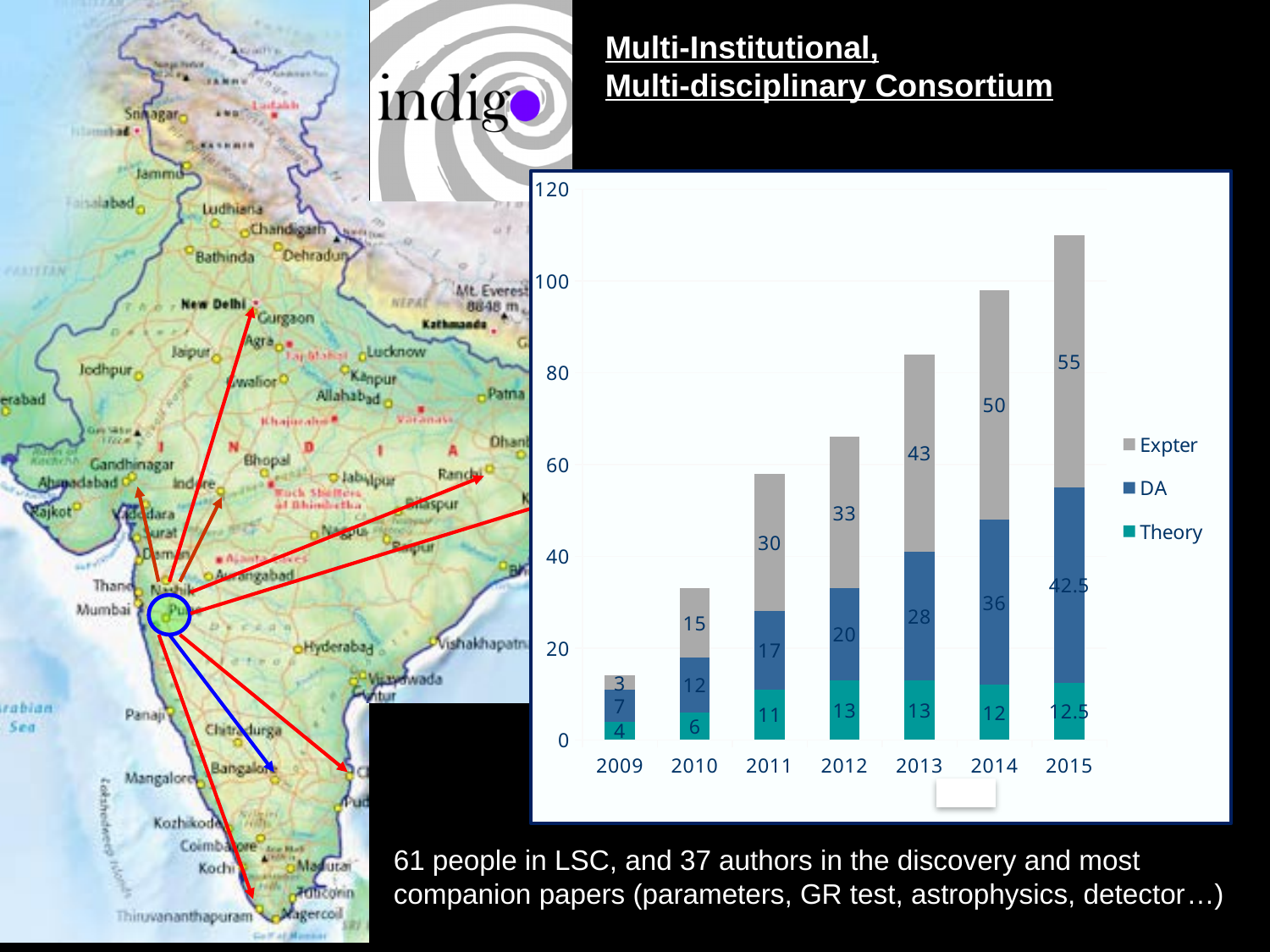
What is the difference between the DA values for 2014 and 2013? 8 Which is larger, the Expter value for 2012 or the Expter value for 2011? 2012 What is the DA value for 2015? 42.5 What is the Theory value for 2011? 11 What type of chart is shown on the slide? stacked bar chart Which year has the highest Expter value? 2015 How many years are shown on the x axis of the chart? 7 What is the total of the stacked bar for 2010? 33 Does the total stacked bar for 2015 exceed 100? Yes Which year has the lowest DA value? 2009 What is the Expter value for 2014? 50 How many series does the chart legend list? 3